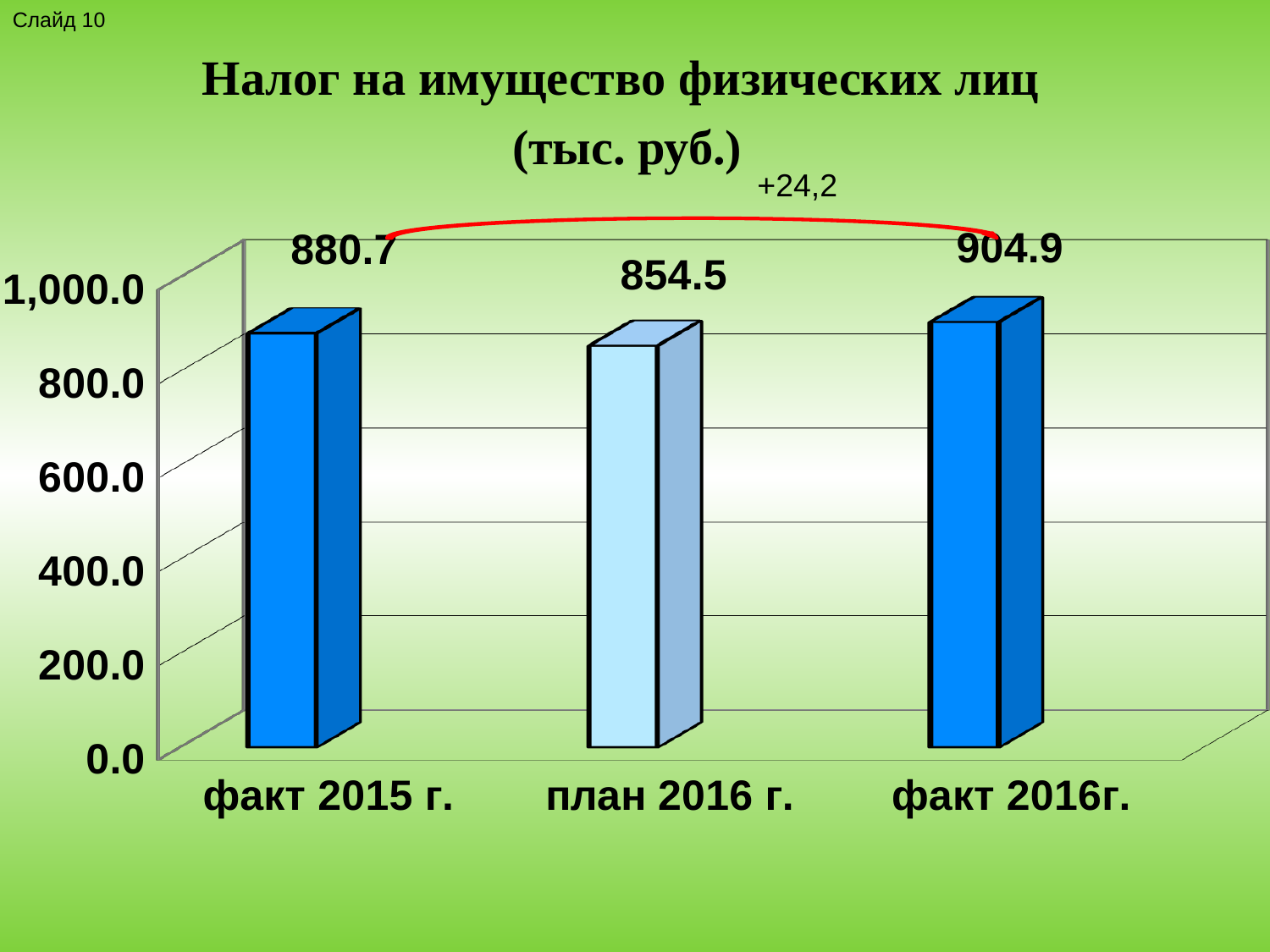
What is the title of the chart? Налог на имущество физических лиц (тыс. руб.) What is the value for план 2016 г.? 854.5 What is the value for факт 2016г.? 904.9 Which is larger, факт 2016г. or план 2016 г.? факт 2016г. Is the value for план 2016 г. greater or less than 800.0? greater Which category has the highest value? факт 2016г. What kind of chart is shown on the slide? bar chart What is the difference between факт 2016г. and факт 2015 г.? 24.2 What is the value for факт 2015 г.? 880.7 Which category has the lowest value? план 2016 г. How many categories are shown on the chart? 3 What is the difference between факт 2015 г. and план 2016 г.? 26.2